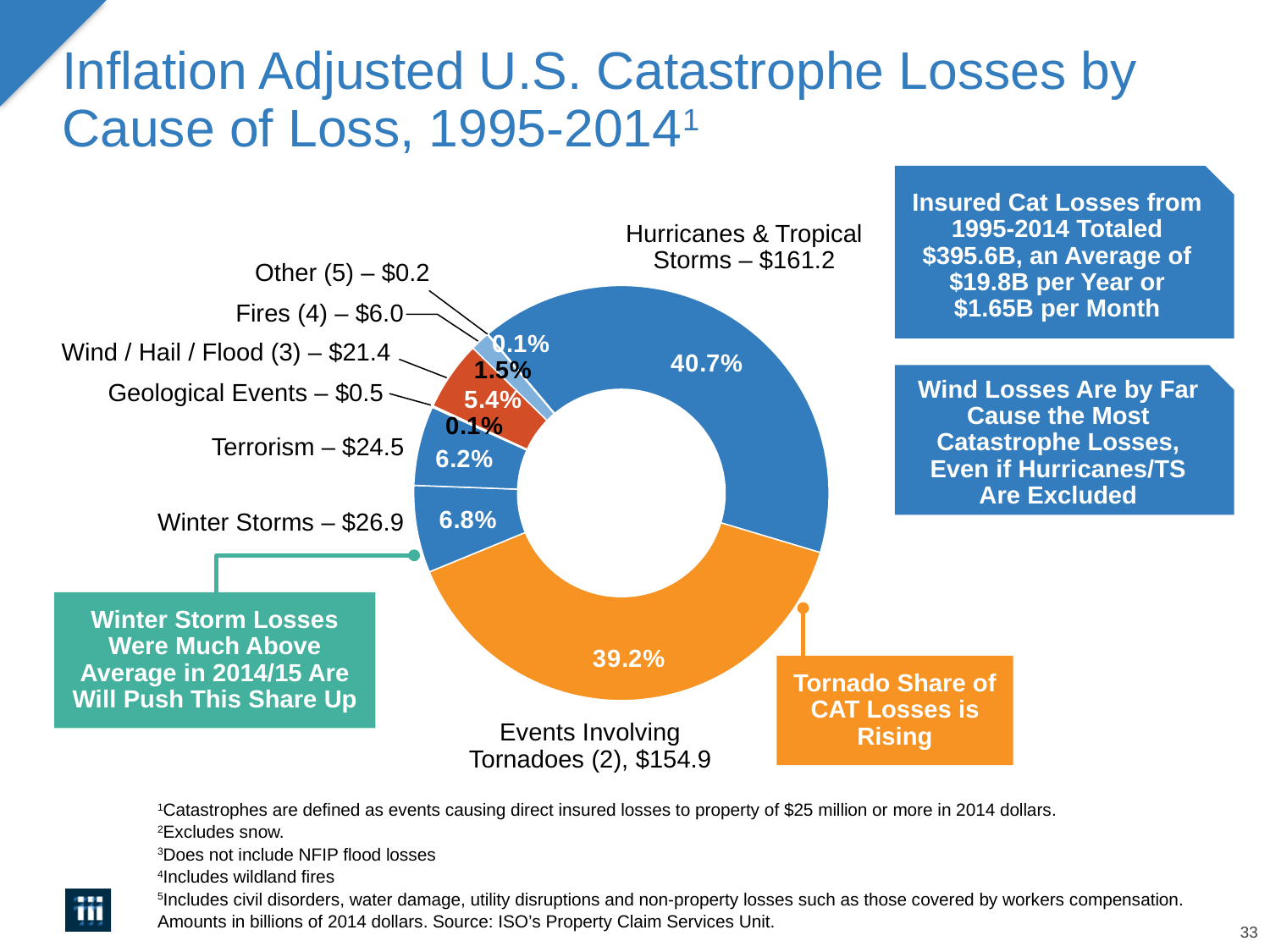
What percentage share does Terrorism have? 6.2% According to the callout box, what did insured cat losses from 1995-2014 total? $395.6B Which cause of loss has the smallest dollar amount? Other What share of catastrophe losses is attributed to Events Involving Tornadoes? 39.2% How many categories (slices) does the chart show? 8 What is the difference in losses between Hurricanes & Tropical Storms and Events Involving Tornadoes? $6.3 What kind of chart is shown on the slide? Doughnut (pie) chart Which is larger, the loss amount for Terrorism or for Wind / Hail / Flood? Terrorism What is the loss amount for Hurricanes & Tropical Storms? $161.2 What is the loss amount for Winter Storms? $26.9 Which cause of loss has the largest share of catastrophe losses? Hurricanes & Tropical Storms What share of losses is attributed to Wind / Hail / Flood? 5.4%